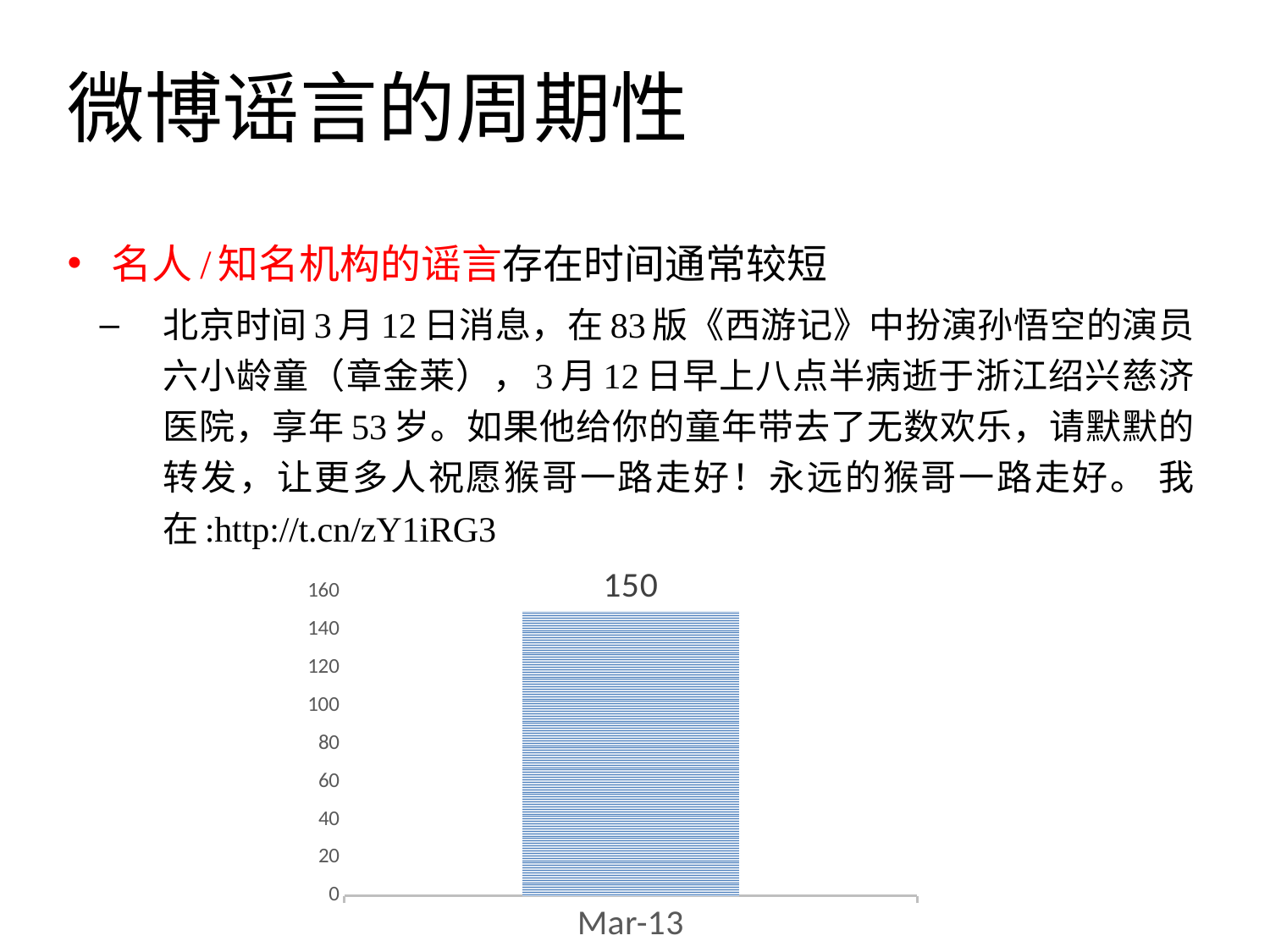
What is the category label shown on the x axis of the chart? Mar-13 How many bars are plotted in the chart? 1 What kind of chart is shown on the slide? bar chart Is the value for Mar-13 greater or less than 140? greater Is the value for Mar-13 greater or less than 160? less What is the value of the bar for Mar-13? 150 What is the highest tick value shown on the y axis of the chart? 160